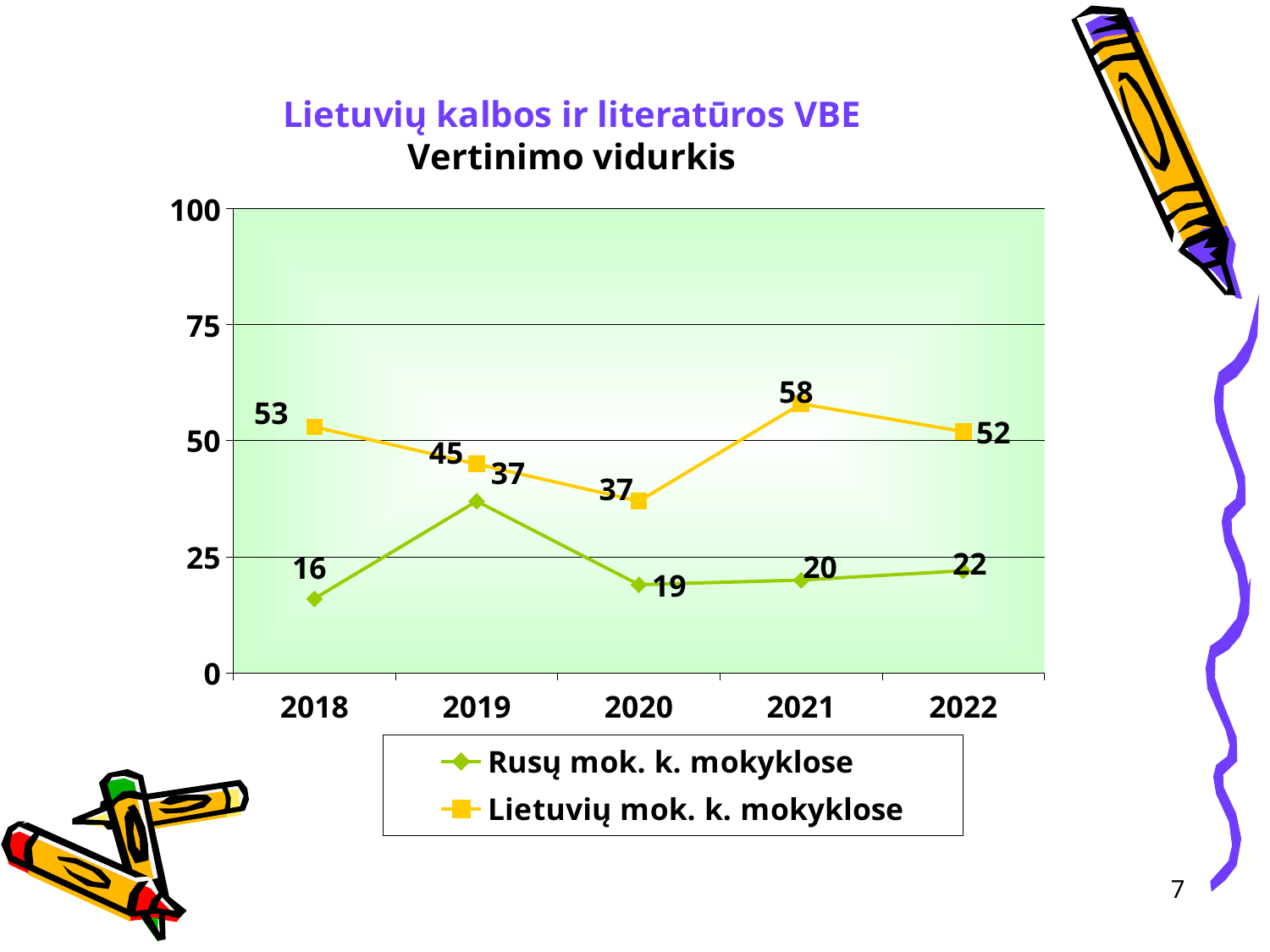
What is the difference between Lietuvių mok. k. mokyklose and Rusų mok. k. mokyklose in 2020? 18 What is the value for Lietuvių mok. k. mokyklose in 2021? 58 What is the value for Rusų mok. k. mokyklose in 2019? 37 What kind of chart is shown on the slide? line chart Is the value for Lietuvių mok. k. mokyklose in 2021 greater or less than 50? greater How many years are shown on the x axis? 5 What is the value for Lietuvių mok. k. mokyklose in 2018? 53 What is the value for Rusų mok. k. mokyklose in 2022? 22 How many series does the legend list? 2 In which year is the value for Lietuvių mok. k. mokyklose highest? 2021 In which year is the value for Rusų mok. k. mokyklose lowest? 2018 Which series has the larger value in 2019, Rusų mok. k. mokyklose or Lietuvių mok. k. mokyklose? Lietuvių mok. k. mokyklose